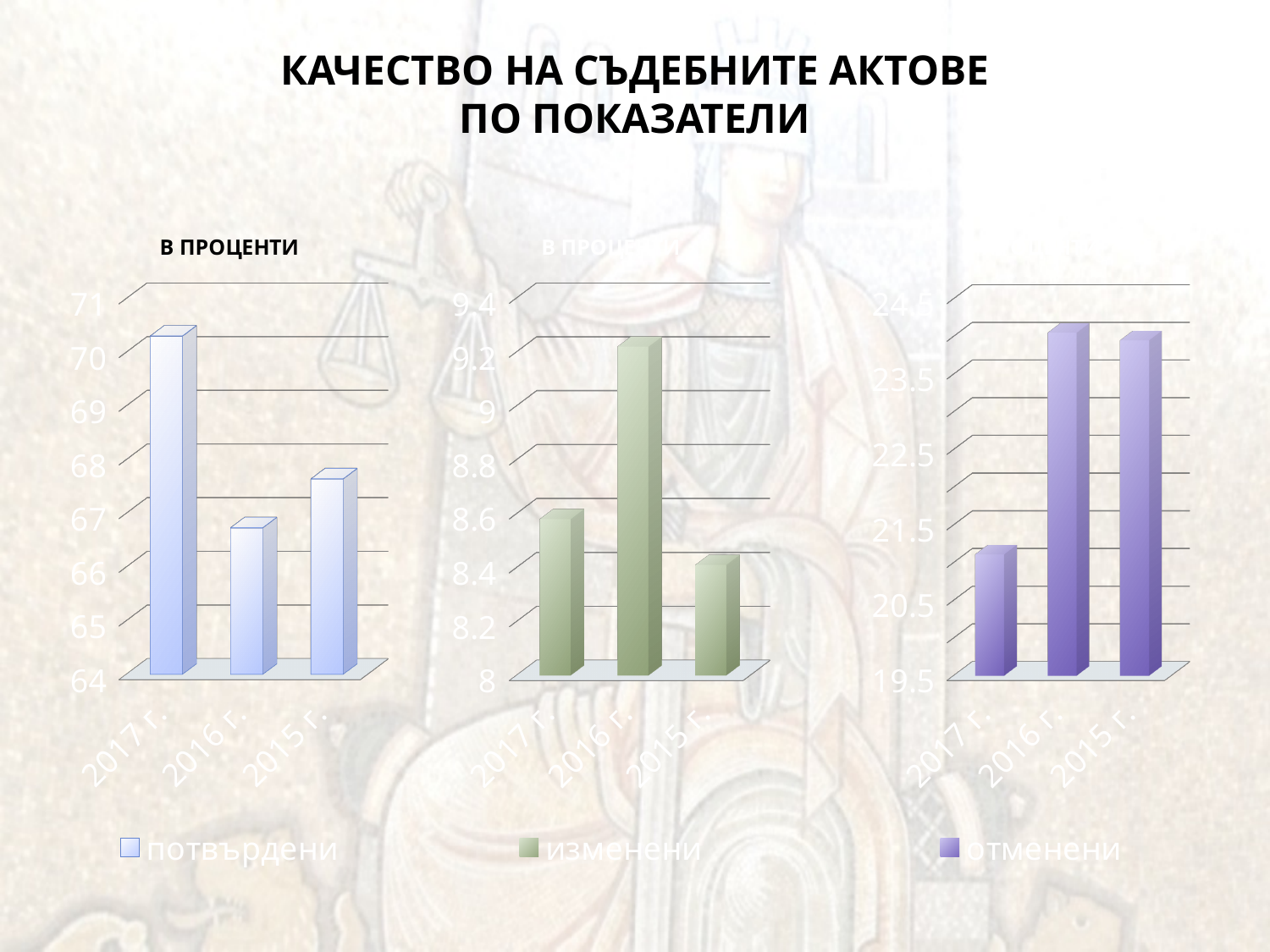
In the middle chart (изменени), which year has the lowest value? 2015 г. In the right chart (отменени), which year has the lowest value? 2017 г. In the middle chart (изменени), which year has the highest value? 2016 г. In the left chart (потвърдени), is the value for 2017 г. greater or less than 69? greater How many years are shown on the x axis of the right chart (отменени)? 3 In the middle chart (изменени), is the value for 2016 г. greater or less than 9? greater In the left chart (потвърдени), is the value for 2016 г. greater or less than 68? less What is the legend entry for the middle chart? изменени In the left chart (потвърдени), which year has the lowest value? 2016 г. What kind of chart is the left chart (потвърдени)? bar chart In the left chart (потвърдени), which year has the highest value? 2017 г.